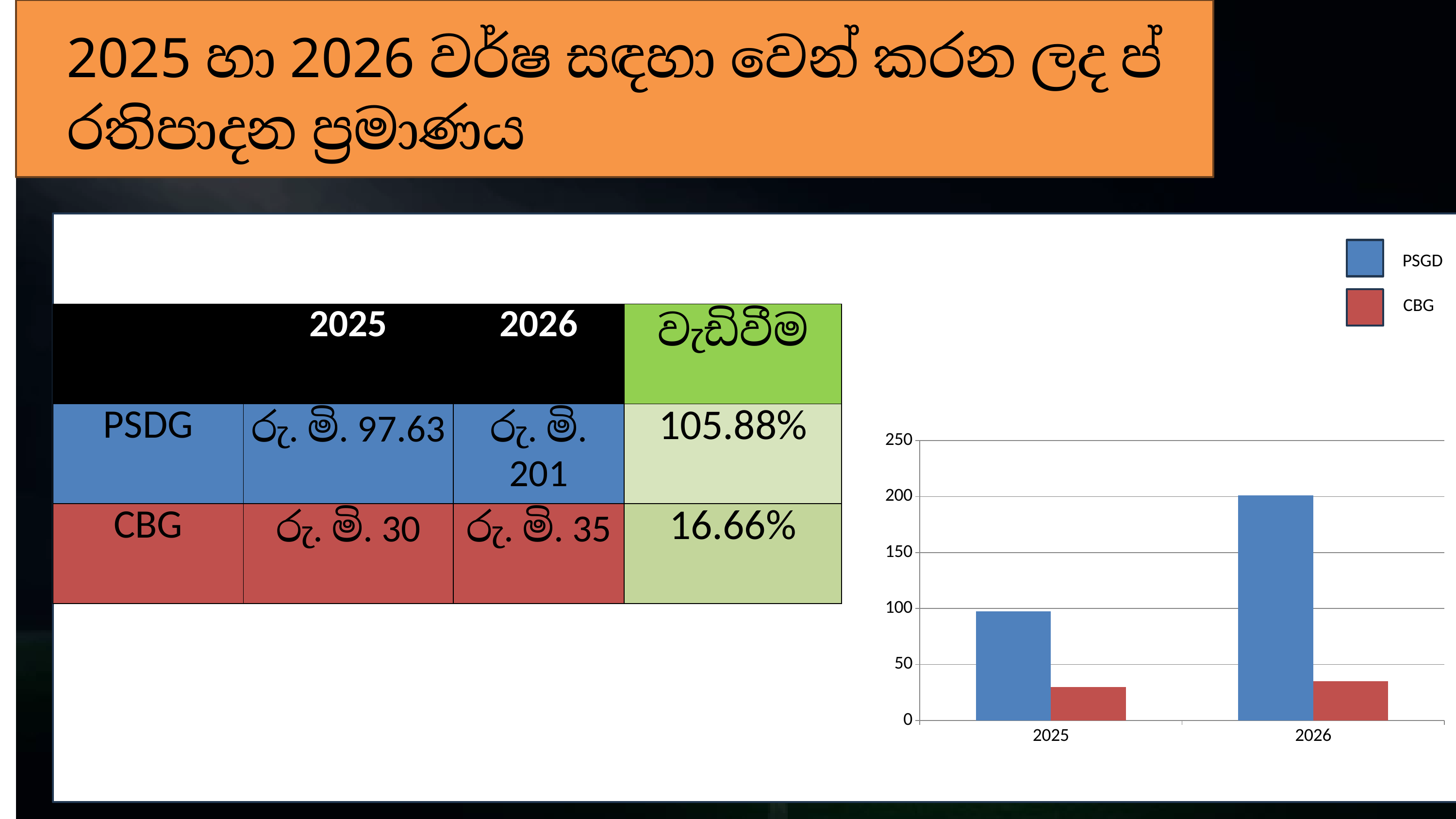
Is the value for PSGD in 2025 greater or less than 50? greater How many categories are shown on the x axis of the chart? 2 Which series in the chart is shown in red? CBG What kind of chart is shown on the right of the slide? bar chart Which is larger in the chart: PSGD in 2025 or PSGD in 2026? PSGD in 2026 Does the PSGD series rise or fall from 2025 to 2026? rise Is the value for CBG in 2025 greater or less than 50? less Is the value for CBG in 2026 greater or less than 50? less Which is larger in the chart for 2025: PSGD or CBG? PSGD Which series in the chart is shown in blue? PSGD How many series does the chart's legend list? 2